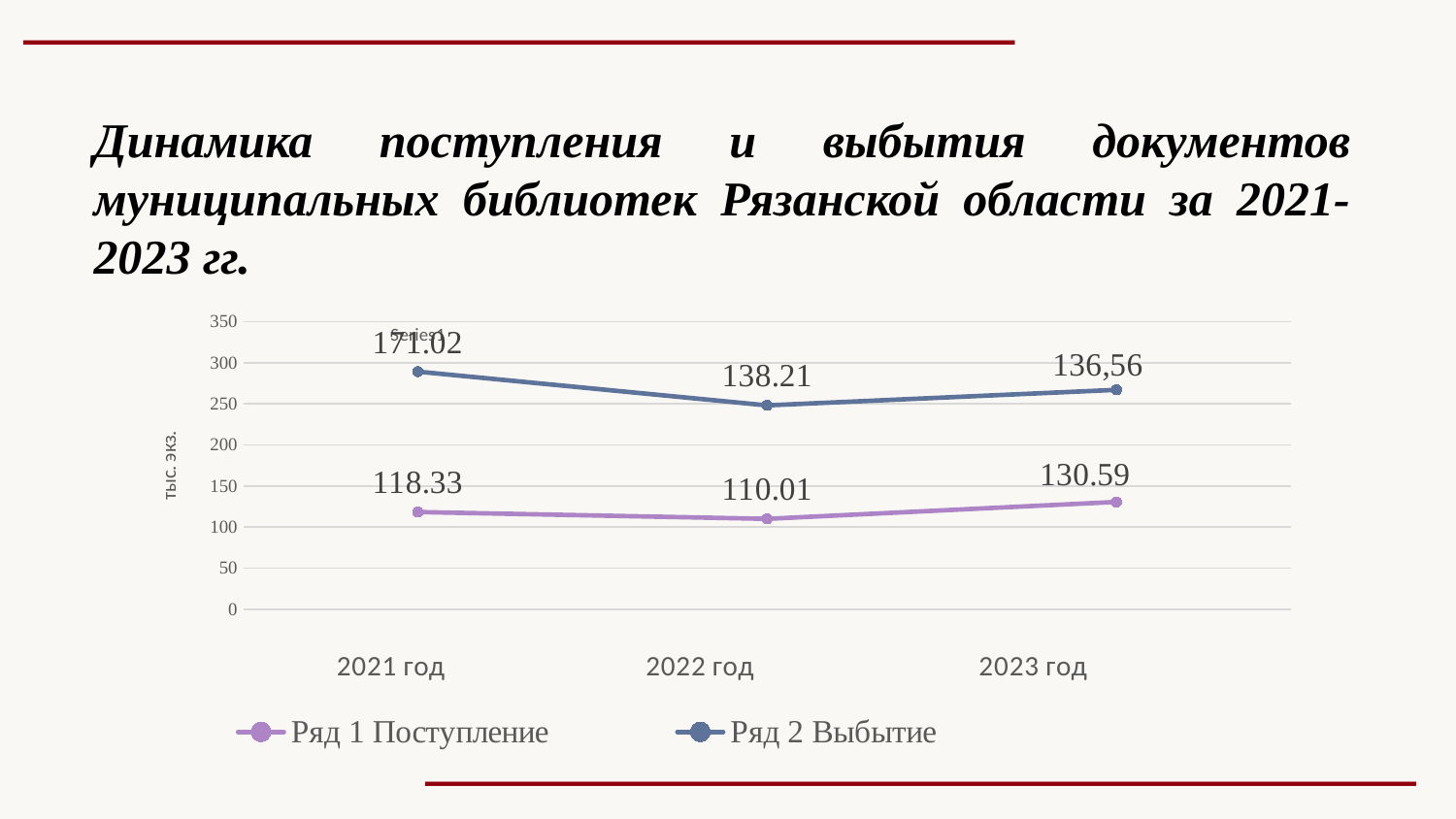
What is the value for Ряд 2 Выбытие in 2022 год? 138.21 In which year is the value for Ряд 1 Поступление the lowest? 2022 год What is the difference between Ряд 2 Выбытие and Ряд 1 Поступление in 2021 год? 52.69 How many years are plotted along the x axis? 3 What unit is shown on the vertical axis label? тыс. экз. In which year is the value for Ряд 2 Выбытие the highest? 2021 год How many series does the legend list? 2 What is the value for Ряд 1 Поступление in 2023 год? 130.59 What kind of chart is shown on the slide? line chart What is the value for Ряд 1 Поступление in 2021 год? 118.33 Which is larger in 2022 год: Ряд 1 Поступление or Ряд 2 Выбытие? Ряд 2 Выбытие What is the value for Ряд 2 Выбытие in 2023 год? 136,56